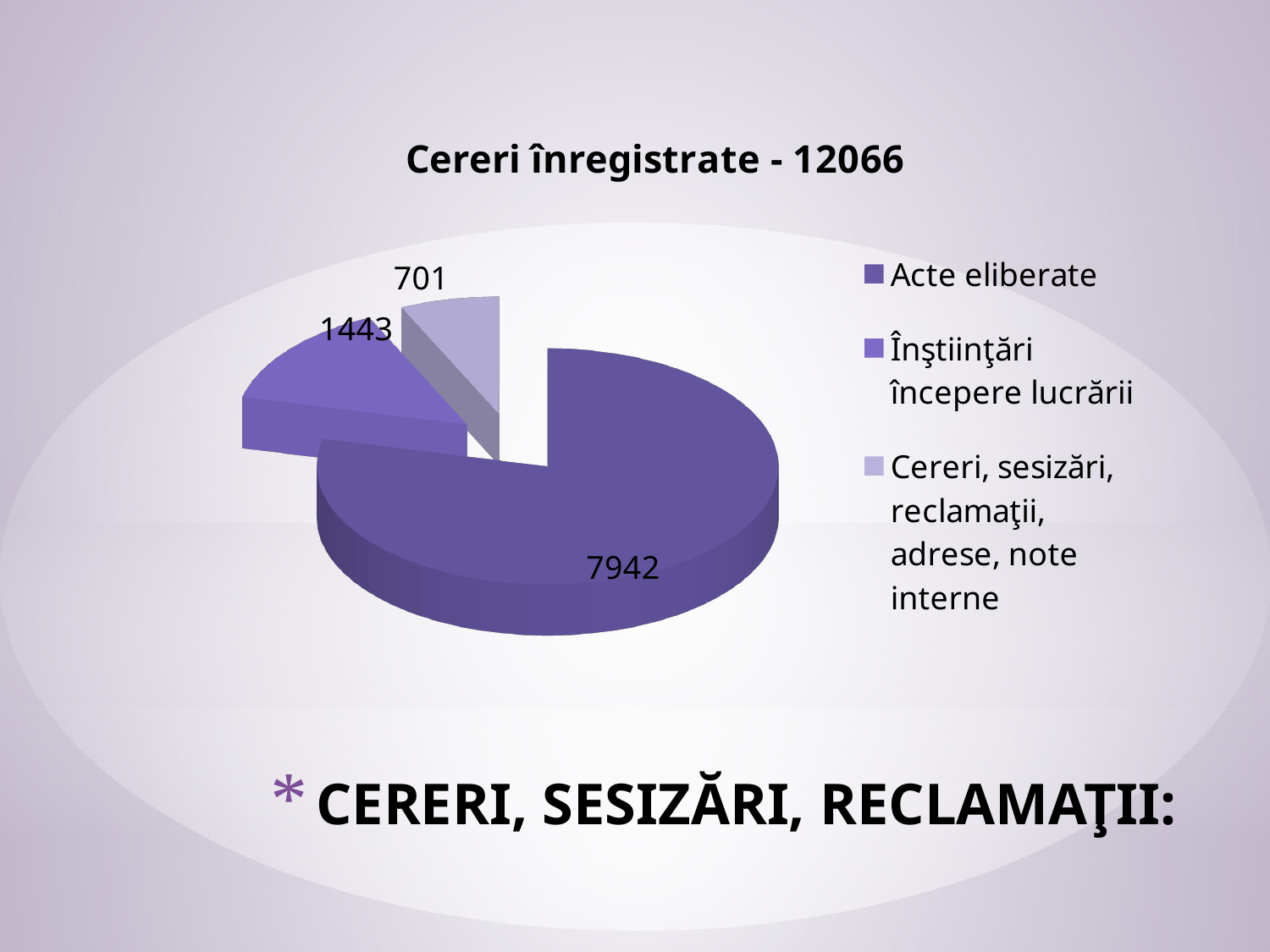
Which category has the largest slice of the pie? Acte eliberate What is the value for Acte eliberate? 7942 Which category has the smallest slice of the pie? Cereri, sesizări, reclamaţii, adrese, note interne How many entries does the legend list? 3 Which is larger, the value for Înştiinţări începere lucrării or the value for Cereri, sesizări, reclamaţii, adrese, note interne? Înştiinţări începere lucrării What kind of chart is shown on the slide? Pie chart What is the difference between the values for Înştiinţări începere lucrării and Cereri, sesizări, reclamaţii, adrese, note interne? 742 What is the value for Cereri, sesizări, reclamaţii, adrese, note interne? 701 How many slices does the pie chart have? 3 What is the title of the chart? Cereri înregistrate - 12066 What is the value for Înştiinţări începere lucrării? 1443 What is the difference between the values for Acte eliberate and Înştiinţări începere lucrării? 6499